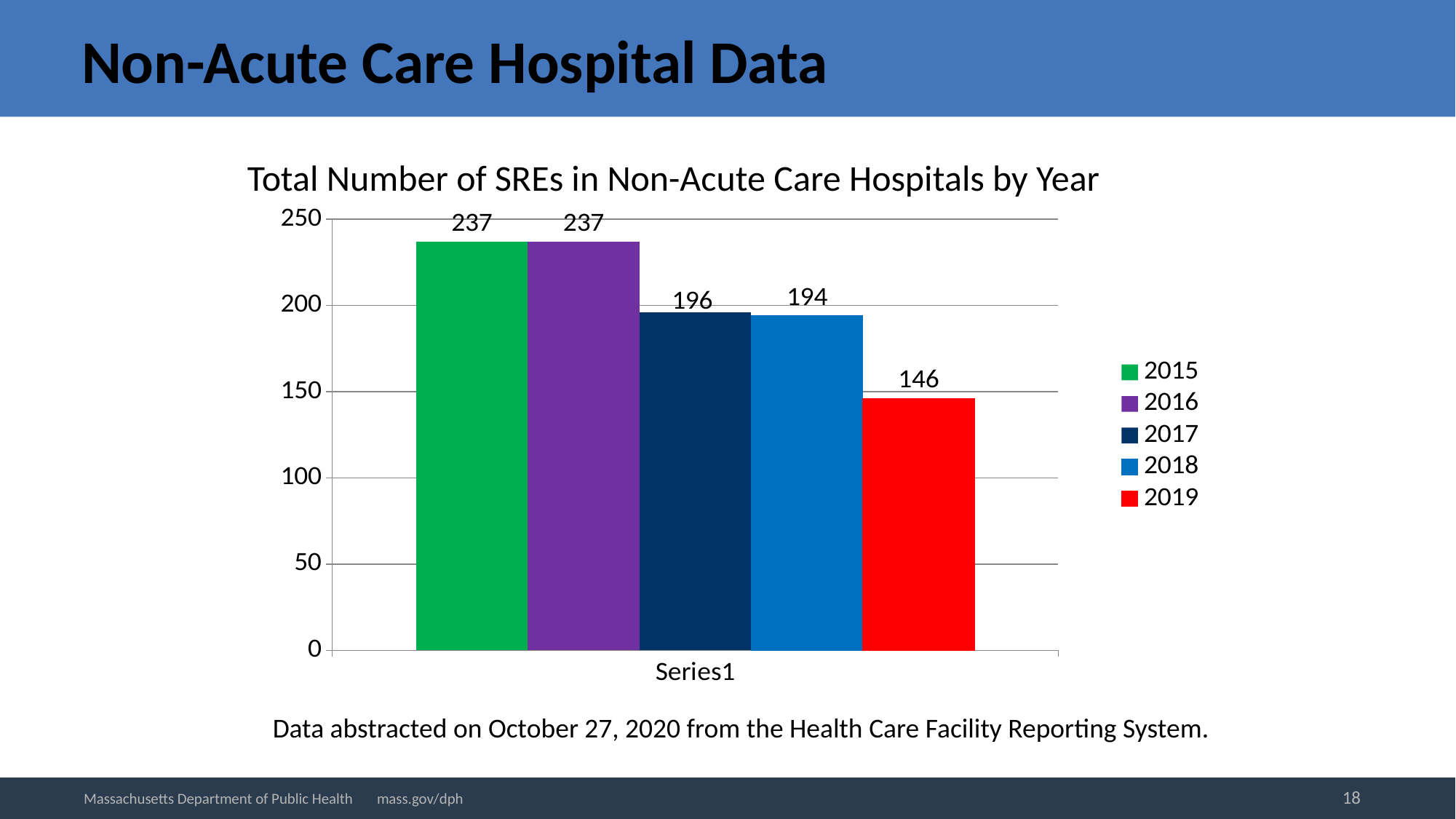
Which year has the lowest number of SREs in non-acute care hospitals? 2019 What is the total number of SREs in non-acute care hospitals for 2017? 196 What is the total number of SREs in non-acute care hospitals for 2018? 194 Do the number of SREs rise or fall from 2015 to 2019? fall Which year has more SREs, 2015 or 2019? 2015 What kind of chart is shown on the slide? bar chart Is the value for 2018 greater or less than 150? greater What is the total number of SREs in non-acute care hospitals for 2019? 146 What is the difference in the number of SREs between 2016 and 2019? 91 What is the difference in the number of SREs between 2017 and 2018? 2 How many entries does the legend list? 5 How many years are shown in the chart? 5